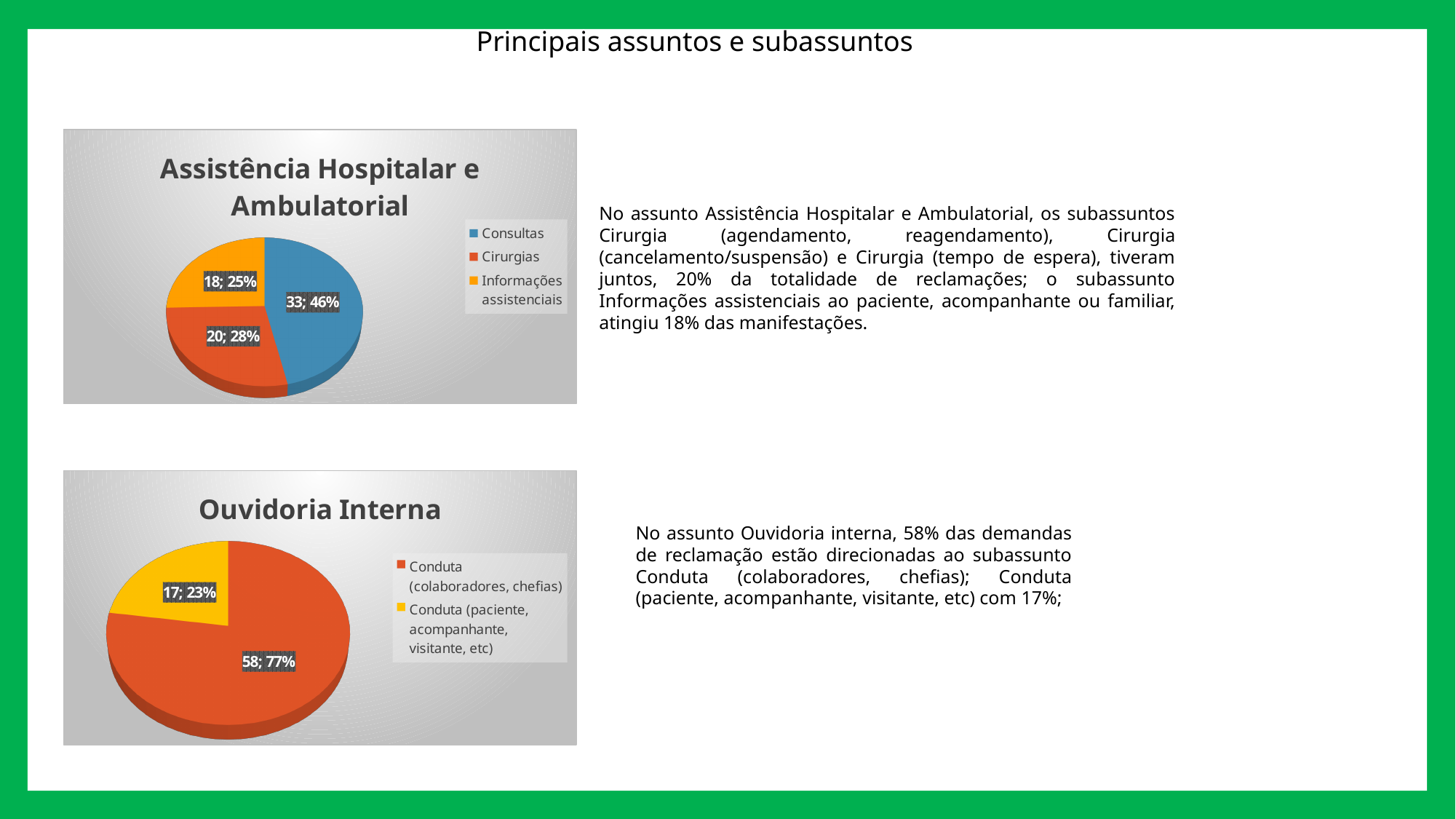
In the 'Assistência Hospitalar e Ambulatorial' chart, what share of the pie does Cirurgias have? 28% In the 'Ouvidoria Interna' chart, what colour is the slice for Conduta (paciente, acompanhante, visitante, etc)? Yellow In the 'Assistência Hospitalar e Ambulatorial' chart, what value is shown for Consultas? 33; 46% In the 'Assistência Hospitalar e Ambulatorial' chart, which category has the smallest slice? Informações assistenciais In the 'Ouvidoria Interna' chart, what share of the pie does Conduta (paciente, acompanhante, visitante, etc) have? 23% In the 'Ouvidoria Interna' chart, which is larger: Conduta (colaboradores, chefias) or Conduta (paciente, acompanhante, visitante, etc)? Conduta (colaboradores, chefias) In the 'Assistência Hospitalar e Ambulatorial' chart, which category has the largest slice? Consultas What type of chart is the 'Ouvidoria Interna' chart? Pie chart In the 'Assistência Hospitalar e Ambulatorial' chart, what is the difference between the counts for Consultas and Cirurgias? 13 In the 'Ouvidoria Interna' chart, what value is shown for Conduta (colaboradores, chefias)? 58; 77% In the 'Assistência Hospitalar e Ambulatorial' chart, what is the count shown for Informações assistenciais? 18 How many categories does the 'Assistência Hospitalar e Ambulatorial' chart show? 3